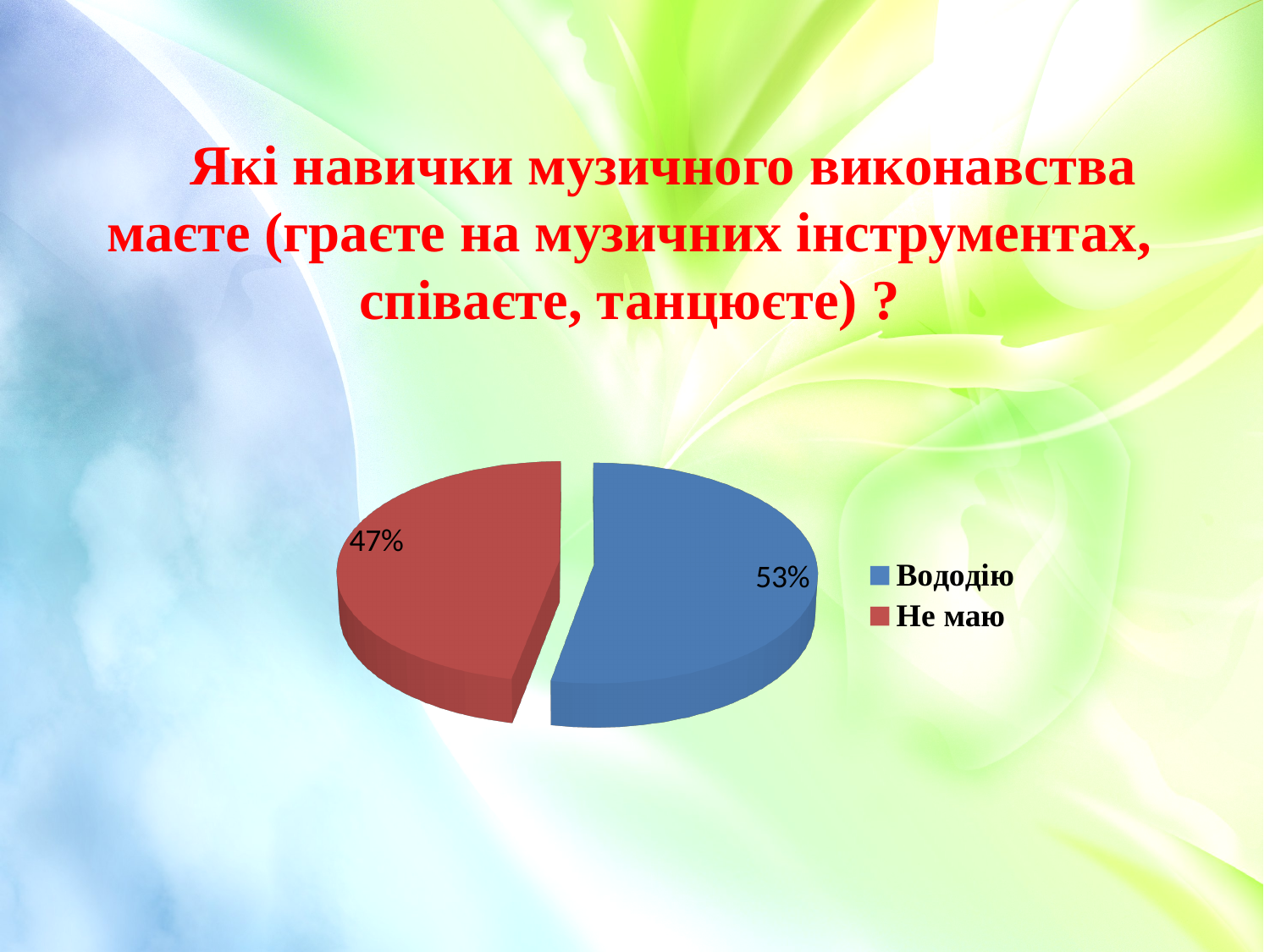
Which slice of the pie is the largest? Вододію What percentage is shown for the "Не маю" slice? 47% What is the difference in percentage points between the "Вододію" and "Не маю" slices? 6 How many entries does the legend list? 2 What colour is the "Вододію" slice? Blue How many slices does the pie chart have? 2 What percentage is shown for the "Вододію" slice? 53% Which slice of the pie is the smallest? Не маю Which is larger, the "Вододію" slice or the "Не маю" slice? Вододію What kind of chart is shown on the slide? Pie chart What colour is the "Не маю" slice? Red What share of the pie does the "Не маю" slice represent? 47%